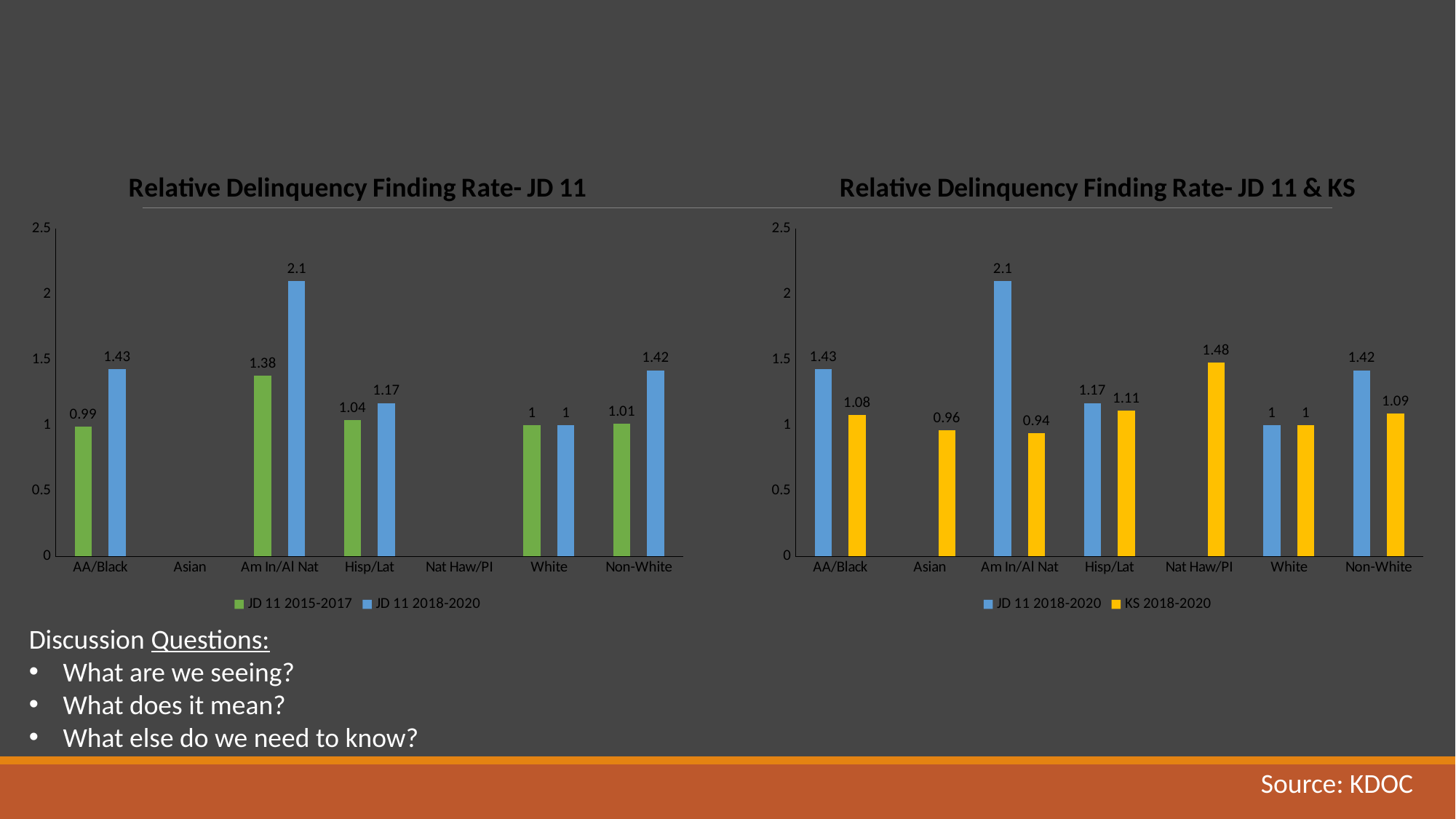
In the 'Relative Delinquency Finding Rate- JD 11 & KS' chart, what is the KS 2018-2020 value for Nat Haw/PI? 1.48 In the 'Relative Delinquency Finding Rate- JD 11' chart, which category has the highest JD 11 2018-2020 value? Am In/Al Nat In the 'Relative Delinquency Finding Rate- JD 11' chart, how many categories are shown on the x axis? 7 In the 'Relative Delinquency Finding Rate- JD 11 & KS' chart, which category has the lowest KS 2018-2020 value? Am In/Al Nat In the 'Relative Delinquency Finding Rate- JD 11' chart, what is the difference between the JD 11 2018-2020 and JD 11 2015-2017 values for AA/Black? 0.44 What type of chart is the 'Relative Delinquency Finding Rate- JD 11 & KS' chart? Bar chart In the 'Relative Delinquency Finding Rate- JD 11' chart, how many series does the legend list? 2 In the 'Relative Delinquency Finding Rate- JD 11' chart, what is the value for Am In/Al Nat in the JD 11 2018-2020 series? 2.1 In the 'Relative Delinquency Finding Rate- JD 11 & KS' chart, what is the difference between the JD 11 2018-2020 and KS 2018-2020 values for Am In/Al Nat? 1.16 In the 'Relative Delinquency Finding Rate- JD 11 & KS' chart, what is the KS 2018-2020 value for Asian? 0.96 In the 'Relative Delinquency Finding Rate- JD 11' chart, what is the value for AA/Black in the JD 11 2015-2017 series? 0.99 In the 'Relative Delinquency Finding Rate- JD 11 & KS' chart, which is larger for Non-White: the JD 11 2018-2020 value or the KS 2018-2020 value? JD 11 2018-2020